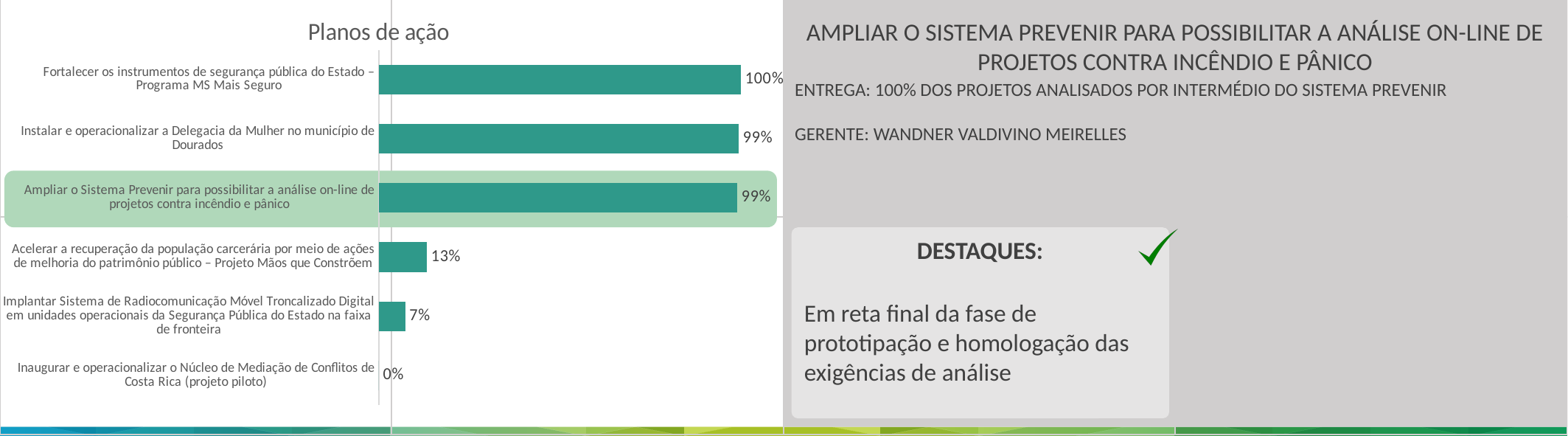
What is the value for 'Ampliar o Sistema Prevenir para possibilitar a análise on-line de projetos contra incêndio e pânico'? 99% What is the value for 'Instalar e operacionalizar a Delegacia da Mulher no município de Dourados'? 99% What is the value for 'Fortalecer os instrumentos de segurança pública do Estado – Programa MS Mais Seguro'? 100% What is the difference between the value for 'Acelerar a recuperação da população carcerária...' (Projeto Mãos que Constrõem) and the value for 'Implantar Sistema de Radiocomunicação Móvel Troncalizado Digital...'? 6% Which is larger: the value for 'Instalar e operacionalizar a Delegacia da Mulher no município de Dourados' or the value for 'Acelerar a recuperação da população carcerária...' (Projeto Mãos que Constrõem)? Instalar e operacionalizar a Delegacia da Mulher no município de Dourados What is the value for 'Acelerar a recuperação da população carcerária por meio de ações de melhoria do patrimônio público – Projeto Mãos que Constrõem'? 13% Which category has the highest value in the chart? Fortalecer os instrumentos de segurança pública do Estado – Programa MS Mais Seguro What is the value for 'Implantar Sistema de Radiocomunicação Móvel Troncalizado Digital em unidades operacionais da Segurança Pública do Estado na faixa de fronteira'? 7% Which category has the lowest value in the chart? Inaugurar e operacionalizar o Núcleo de Mediação de Conflitos de Costa Rica (projeto piloto) What is the title of the chart? Planos de ação How many categories (action plans) are plotted in the chart? 6 What kind of chart is shown on the slide? bar chart